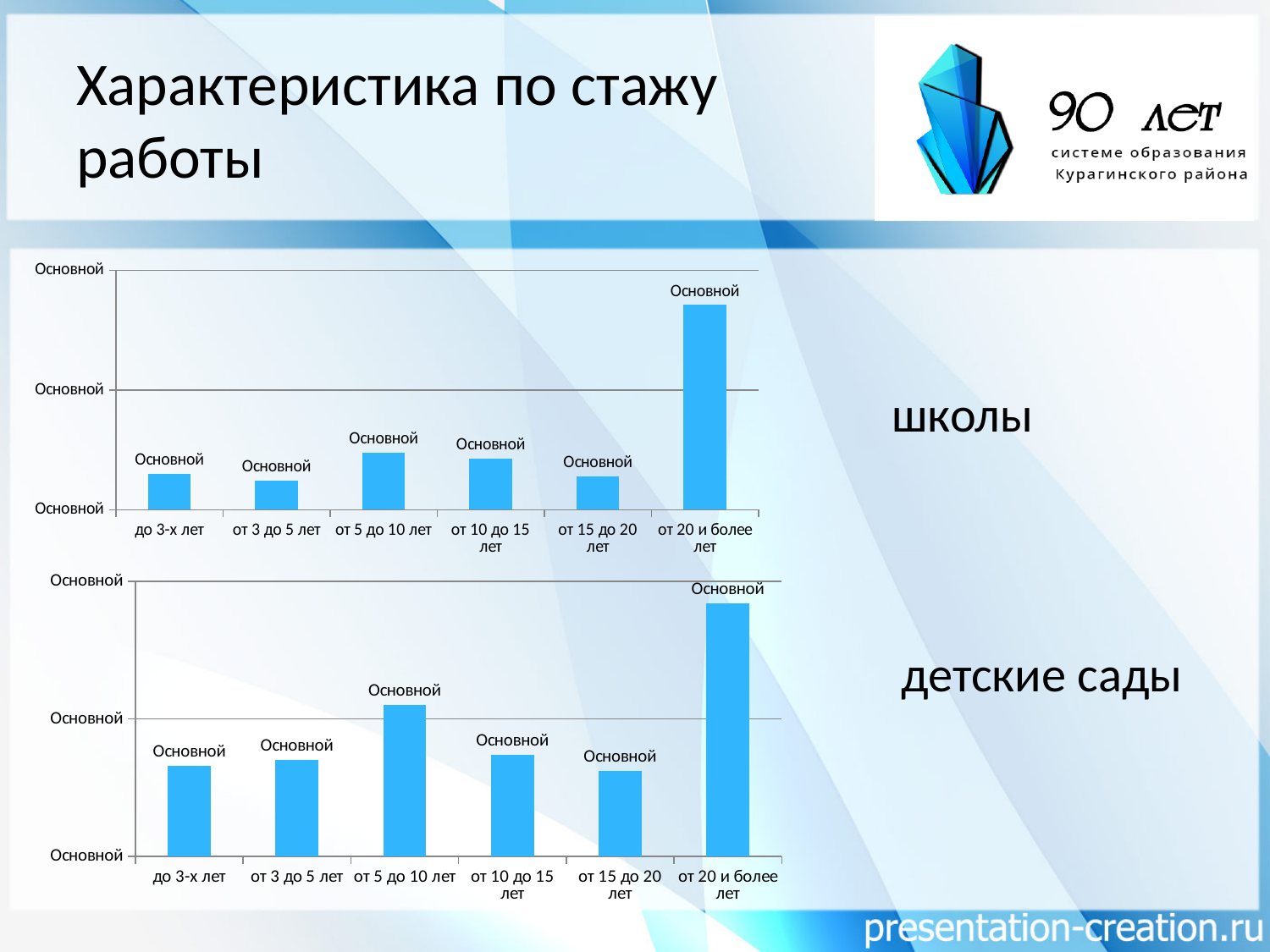
In the top chart («школы»), which is larger: the bar for «от 5 до 10 лет» or the bar for «от 15 до 20 лет»? от 5 до 10 лет In the bottom chart («детские сады»), which is larger: the bar for «от 5 до 10 лет» or the bar for «от 10 до 15 лет»? от 5 до 10 лет In the top chart («школы»), how many categories are shown on the x axis? 6 What text label is shown next to the bottom chart on the slide? детские сады What is the first category on the x axis of the top chart («школы»)? до 3-х лет In the bottom chart («детские сады»), which category has the highest bar? от 20 и более лет In the top chart («школы»), which is larger: the bar for «от 10 до 15 лет» or the bar for «от 3 до 5 лет»? от 10 до 15 лет In the top chart («школы»), which category has the highest bar? от 20 и более лет In the bottom chart («детские сады»), how many bars are plotted? 6 What kind of chart is the top chart labelled «школы»? bar chart What kind of chart is the bottom chart labelled «детские сады»? bar chart